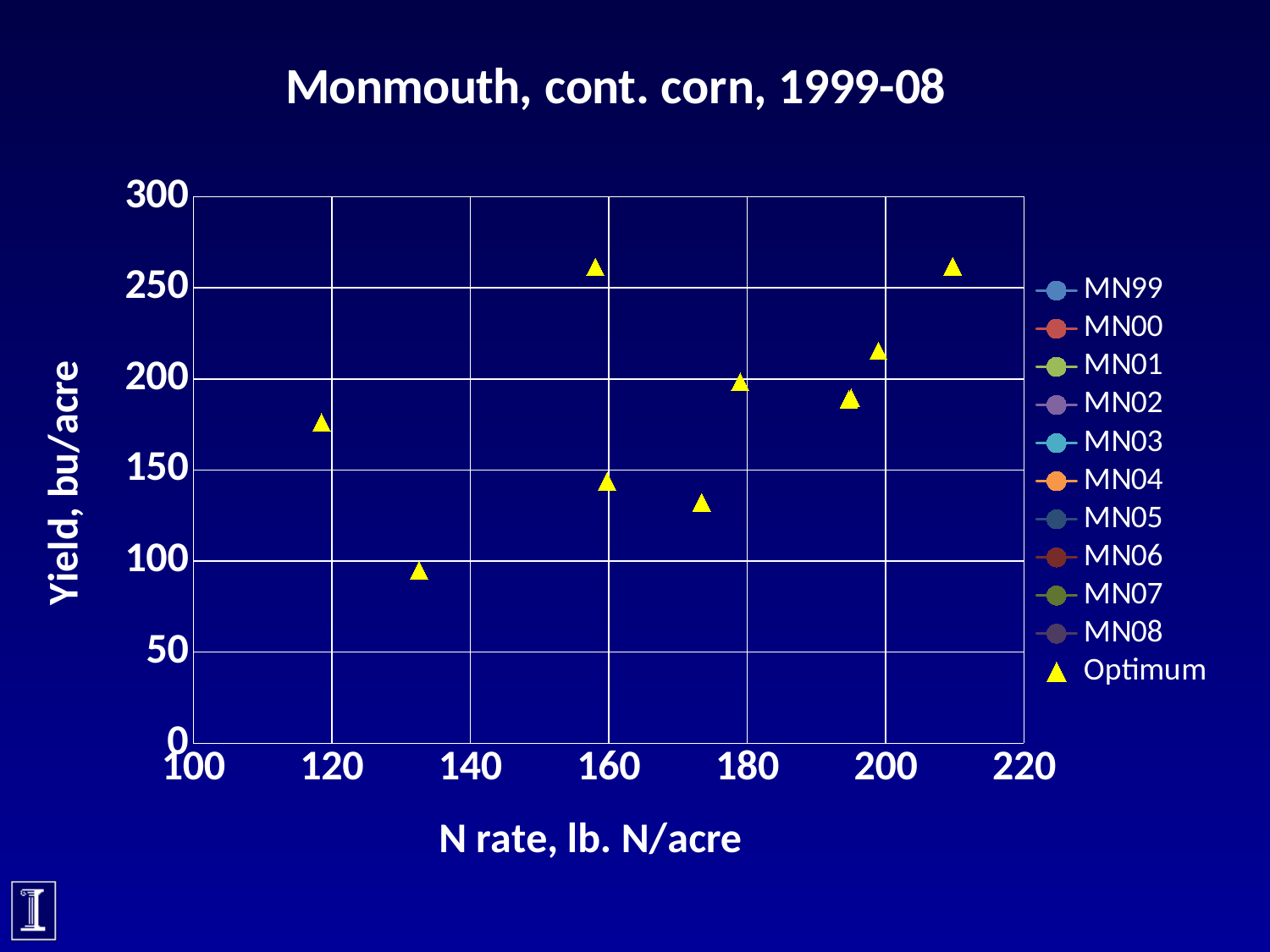
Which has the higher yield: the Optimum point near 120 lb. N/acre or the Optimum point near 133 lb. N/acre? the point near 120 lb. N/acre How many entries does the chart legend list? 11 What is the title of the chart? Monmouth, cont. corn, 1999-08 What is the label of the y axis? Yield, bu/acre What kind of chart is shown on the slide? scatter chart Is the yield of the Optimum point near 173 lb. N/acre greater or less than 150? less Is the N rate of the lowest-yielding Optimum point greater or less than 140? less Is the yield of the Optimum point with the highest N rate (near 210 lb. N/acre) greater or less than 250? greater What is the highest value shown on the y axis? 300